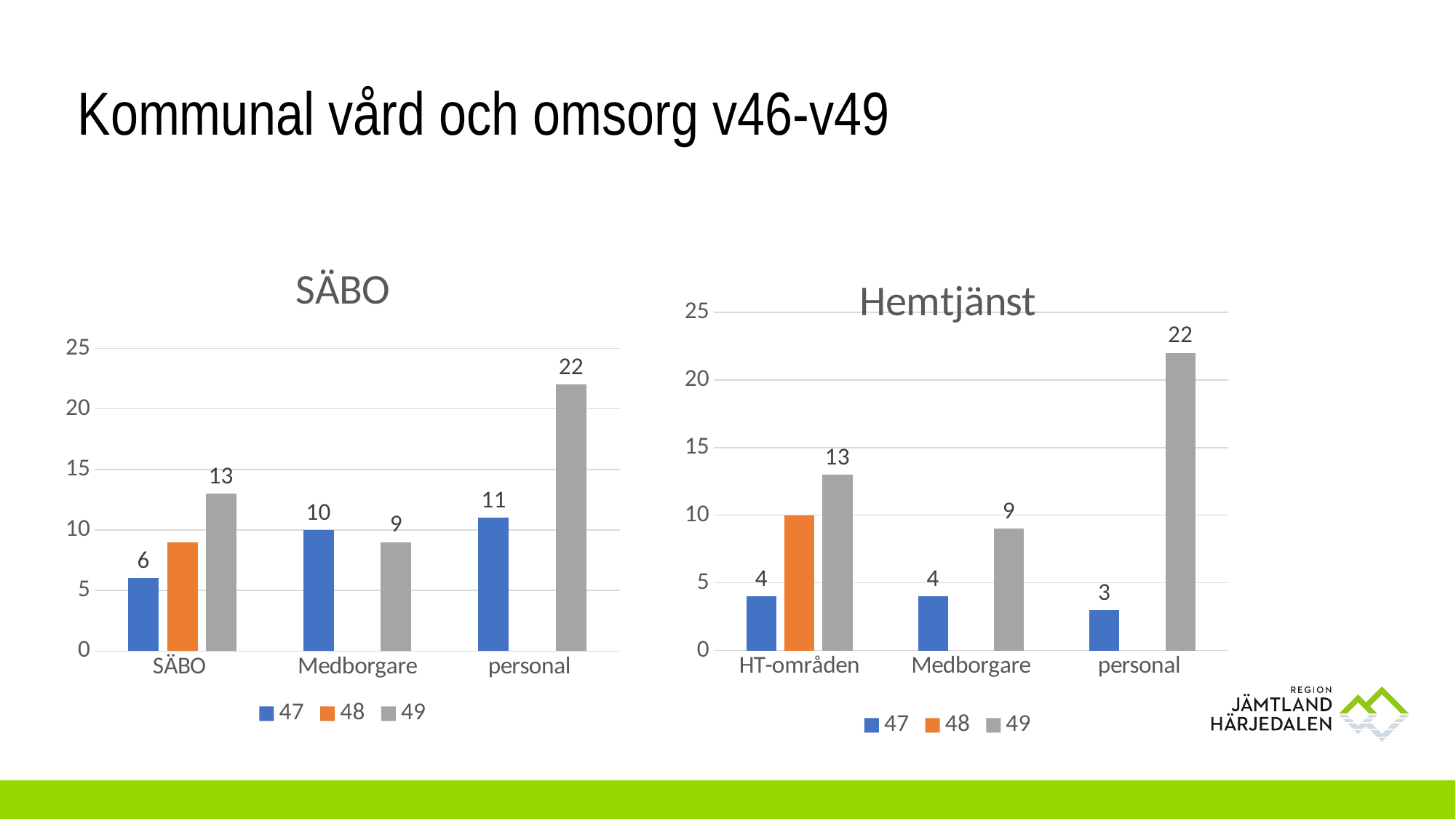
In the Hemtjänst chart, what is the value for series 49 in the HT-områden category? 13 How many series does the legend of the SÄBO chart list? 3 In the SÄBO chart, what is the difference between the series 49 and series 47 values in the personal category? 11 In the Hemtjänst chart, is the value for series 48 in the HT-områden category greater or less than 5? greater In the Hemtjänst chart, which category has the lowest value for series 47? personal In the SÄBO chart, what is the value for series 47 in the SÄBO category? 6 In the Hemtjänst chart, which is larger in the Medborgare category: series 47 or series 49? 49 How many categories are shown on the x axis of the Hemtjänst chart? 3 In the Hemtjänst chart, what is the value for series 47 in the personal category? 3 In the SÄBO chart, what is the value for series 49 in the personal category? 22 What type of chart is the SÄBO chart? bar chart In the SÄBO chart, which category has the highest value for series 49? personal